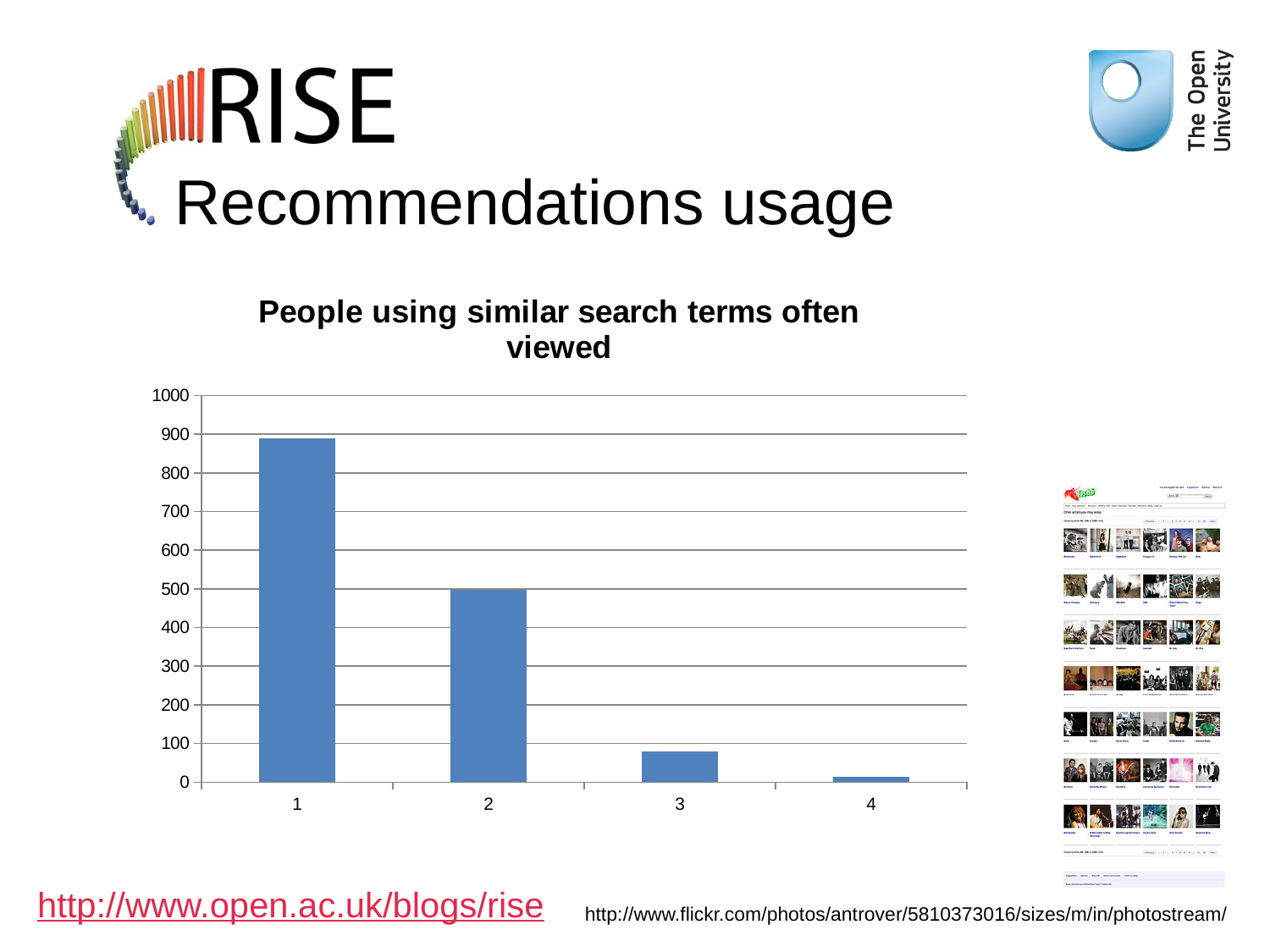
Is the value for category 1 greater or less than 800? greater What is the title of the chart? People using similar search terms often viewed Which has a larger value, category 2 or category 3? 2 Which category has the lowest value in the chart? 4 Is the value for category 2 greater or less than 400? greater What kind of chart is shown on the slide? bar chart Which category has the highest value in the chart? 1 Do the values rise or fall as you move from category 1 to category 4? fall How many categories are shown on the x axis of the chart? 4 Is the value for category 4 greater or less than 100? less What is the maximum value shown on the y axis of the chart? 1000